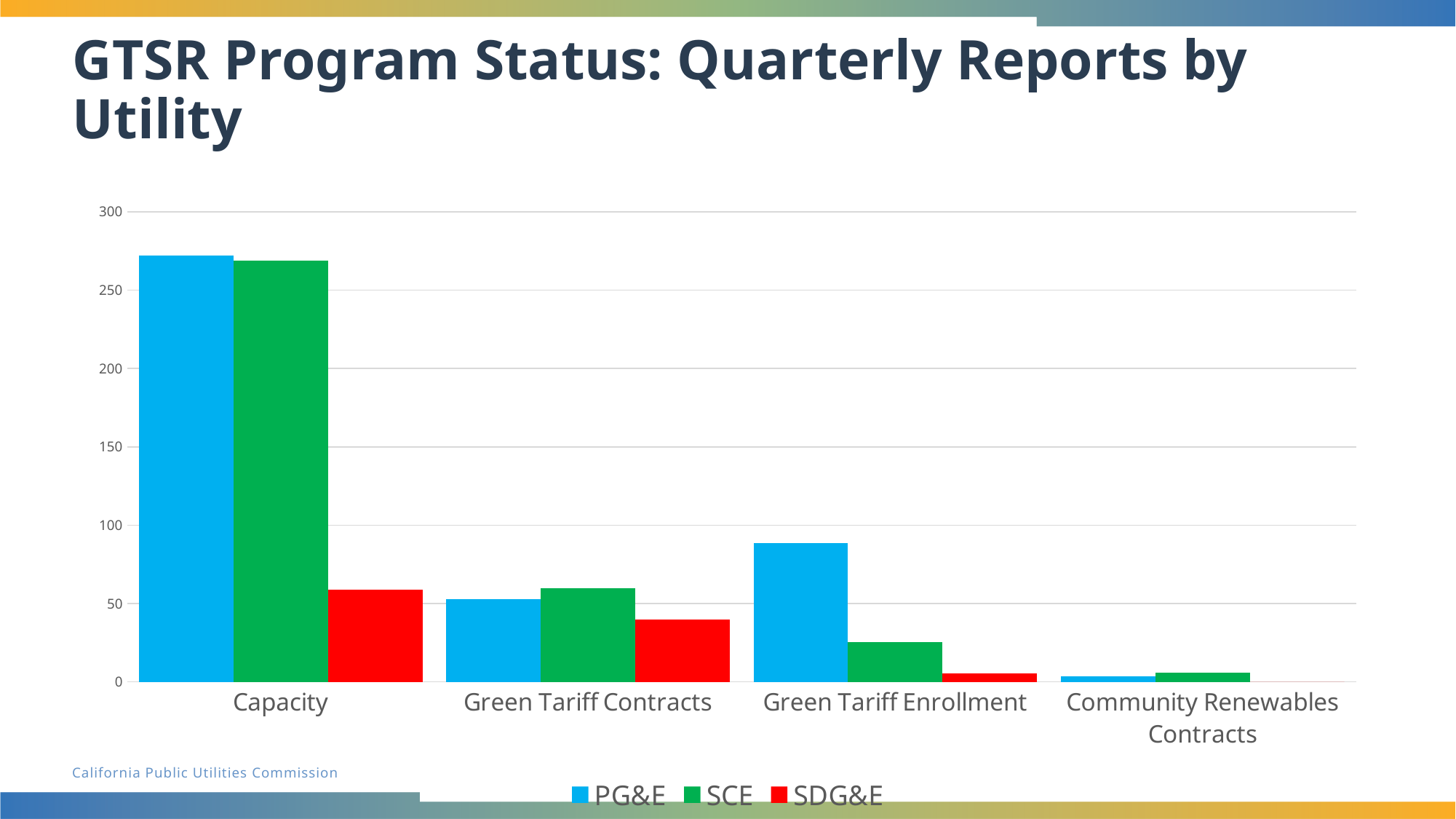
Is the value for PG&E Green Tariff Enrollment greater or less than 100? less Is the value for SDG&E Capacity greater or less than 50? greater For Green Tariff Contracts, which is larger: the value for SCE or the value for SDG&E? SCE Is the value for SCE Green Tariff Enrollment greater or less than 50? less How many categories are shown on the x axis of the chart? 4 Which utility has the lowest value for Capacity? SDG&E Which colour represents SCE in the chart's legend? green What kind of chart is shown on the slide? bar chart How many series does the chart's legend list? 3 Which utility has the highest value for Green Tariff Enrollment? PG&E